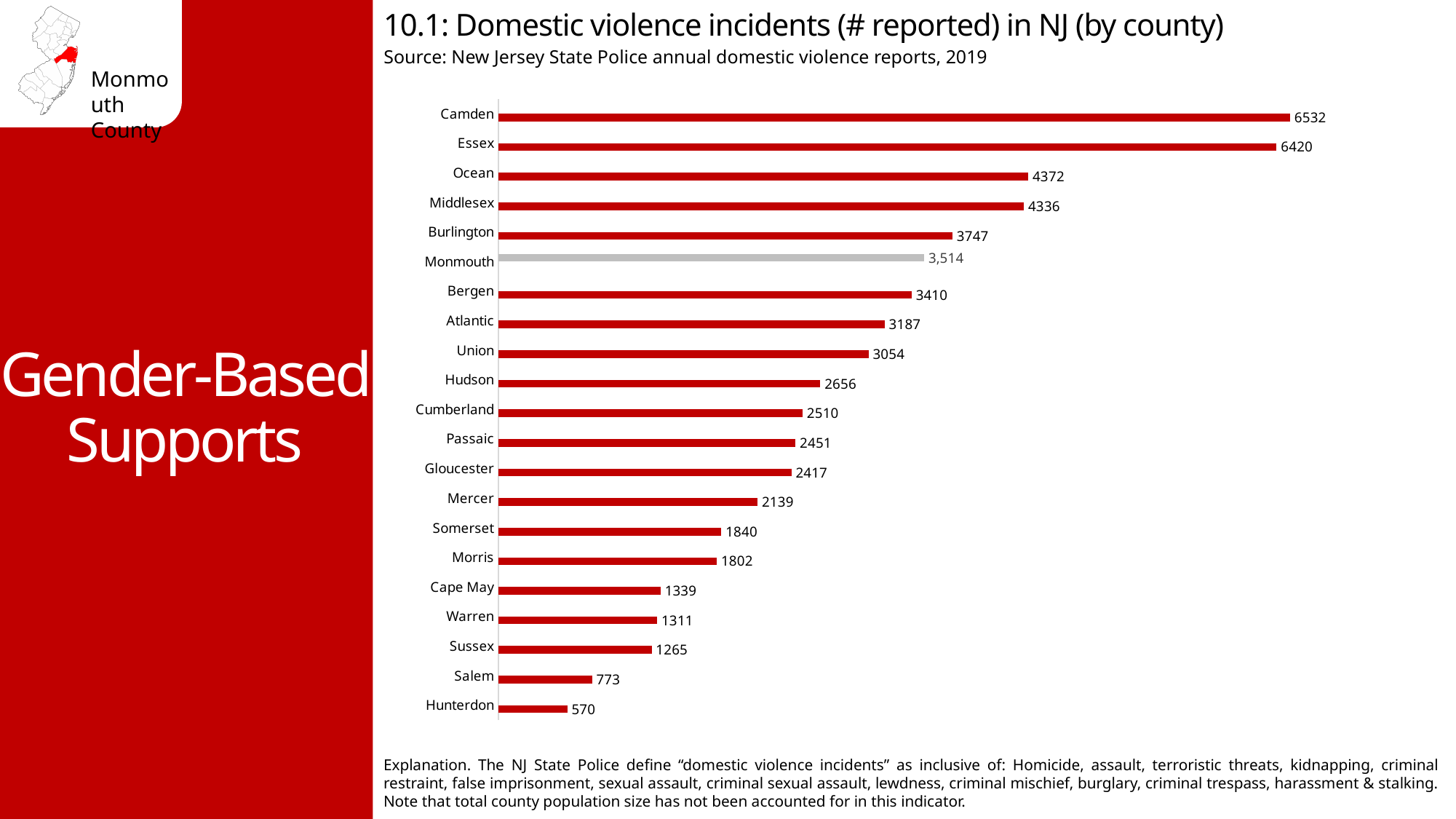
How many counties are shown in the chart? 21 Which county has the highest number of reported domestic violence incidents? Camden Which county has more reported incidents, Salem or Sussex? Sussex What type of chart is used to show domestic violence incidents by county? Bar chart What is the difference in reported incidents between Camden and Essex? 112 Which county has more reported incidents, Bergen or Atlantic? Bergen What is the difference in reported incidents between Ocean and Middlesex? 36 Which county has the lowest number of reported domestic violence incidents? Hunterdon Which county's bar is shown in gray rather than red? Monmouth What is the number of reported domestic violence incidents for Monmouth County? 3,514 What is the number of reported domestic violence incidents for Camden County? 6532 What is the number of reported domestic violence incidents for Hudson County? 2656